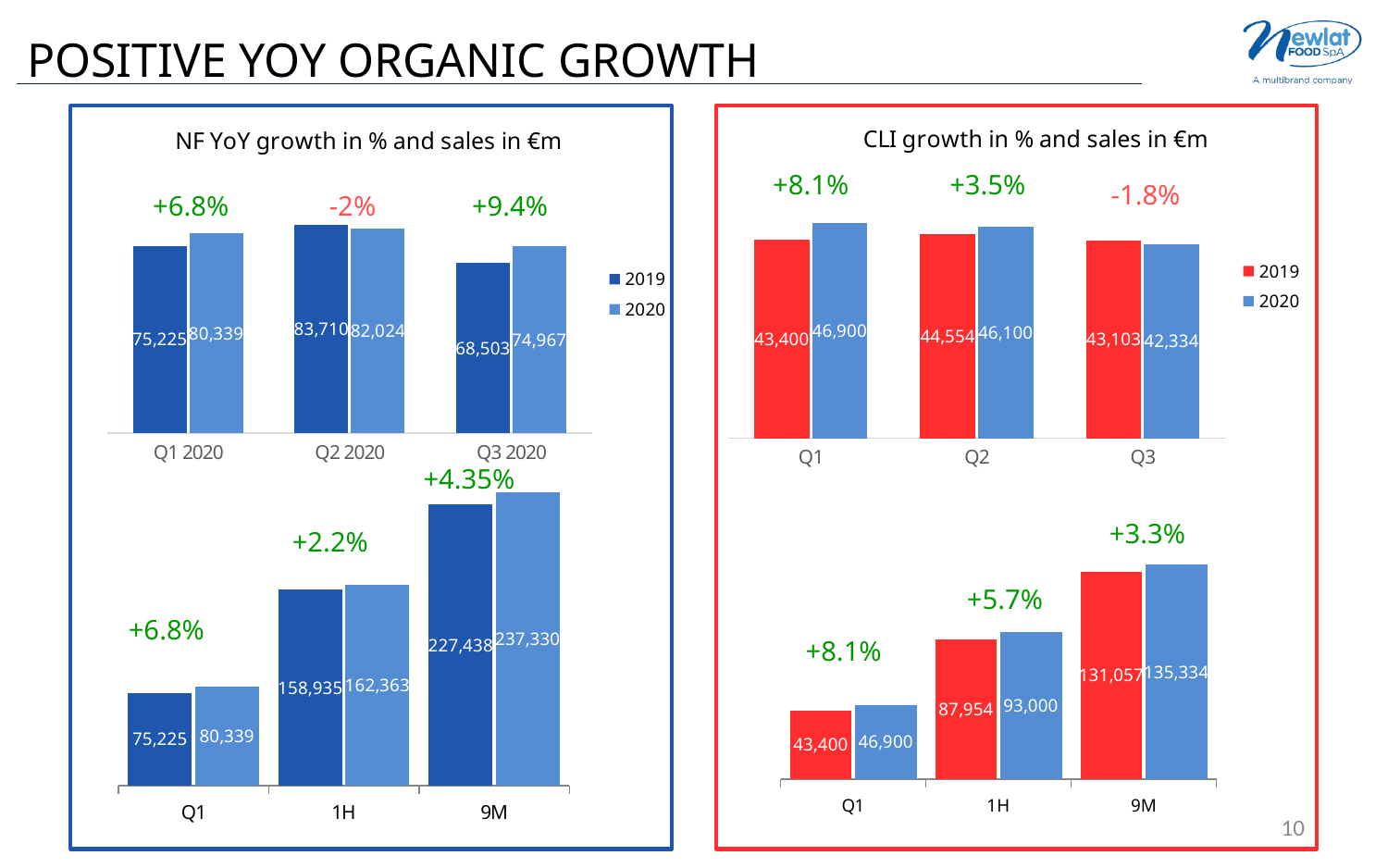
In the top-left chart titled 'NF YoY growth in % and sales in €m', what is the difference between the 2020 and 2019 values for Q3 2020? 6,464 In the top-right chart titled 'CLI growth in % and sales in €m', which quarter has the lowest 2020 value? Q3 In the bottom-right chart (CLI cumulative, categories Q1, 1H, 9M), what is the 2019 value for 1H? 87,954 How many series does the legend of the top-right chart titled 'CLI growth in % and sales in €m' list? 2 In the top-right chart titled 'CLI growth in % and sales in €m', what is the 2019 value for Q3? 43,103 How many categories are shown on the x axis of the bottom-left chart (NF cumulative)? 3 In the top-right chart titled 'CLI growth in % and sales in €m', which is larger for Q2: the 2019 value or the 2020 value? 2020 In the bottom-left chart (NF cumulative, categories Q1, 1H, 9M), what is the 2020 value for 9M? 237,330 In the bottom-right chart (CLI cumulative), what is the difference between the 2020 and 2019 values for 9M? 4,277 In the top-left chart titled 'NF YoY growth in % and sales in €m', what is the 2020 value for Q2 2020? 82,024 What type of chart is the top-left chart titled 'NF YoY growth in % and sales in €m'? Bar chart In the top-left chart titled 'NF YoY growth in % and sales in €m', which quarter has the highest 2019 value? Q2 2020